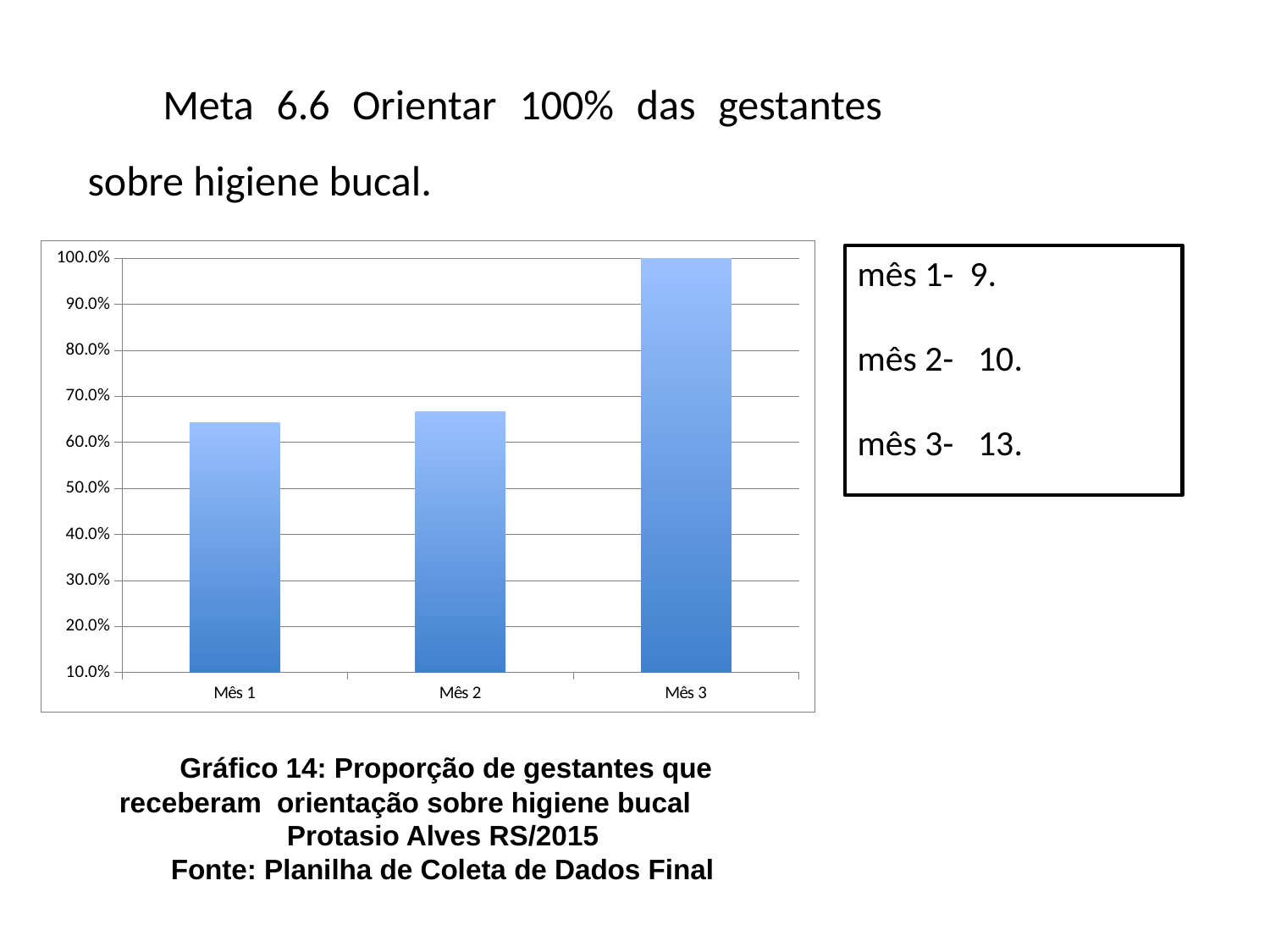
Is the value for Mês 1 greater or less than 60.0%? greater What kind of chart is shown on the slide? bar chart How many categories (months) are plotted in the chart? 3 Is the value for Mês 1 greater or less than 70.0%? less Is the value for Mês 2 greater or less than 70.0%? less According to the caption, what is the source (Fonte) of the chart data? Planilha de Coleta de Dados Final Which month has the highest value in the chart? Mês 3 Do the values rise or fall from Mês 1 to Mês 3? rise What is the value for Mês 3 in the chart? 100.0% What is the number of the graph given in the caption below the chart? Gráfico 14 Which is larger, the value for Mês 2 or the value for Mês 3? Mês 3